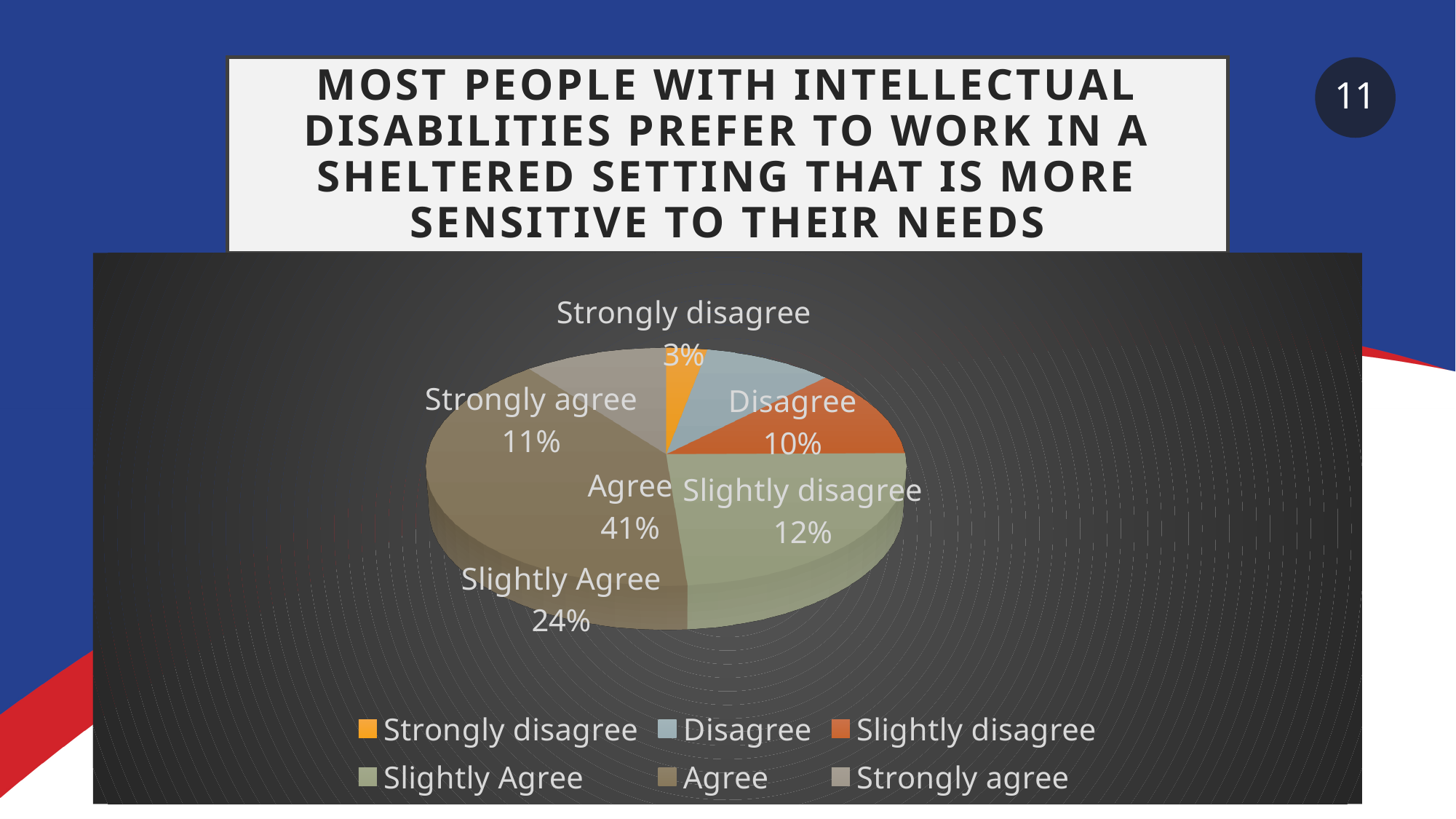
What percentage of respondents chose "Slightly Agree"? 24% What percentage of respondents chose "Strongly disagree"? 3% Which is larger, the share for "Disagree" or the share for "Slightly disagree"? Slightly disagree What percentage of respondents chose "Slightly disagree"? 12% How many response categories are shown in the pie chart? 6 Which response category has the smallest share of the pie? Strongly disagree Which colour represents "Strongly disagree" in the legend? Orange/yellow Which response category has the largest share of the pie? Agree What kind of chart is shown on the slide? Pie chart What percentage of respondents chose "Strongly agree"? 11% What percentage of respondents chose "Agree"? 41% What is the difference in percentage points between "Agree" and "Slightly Agree"? 17